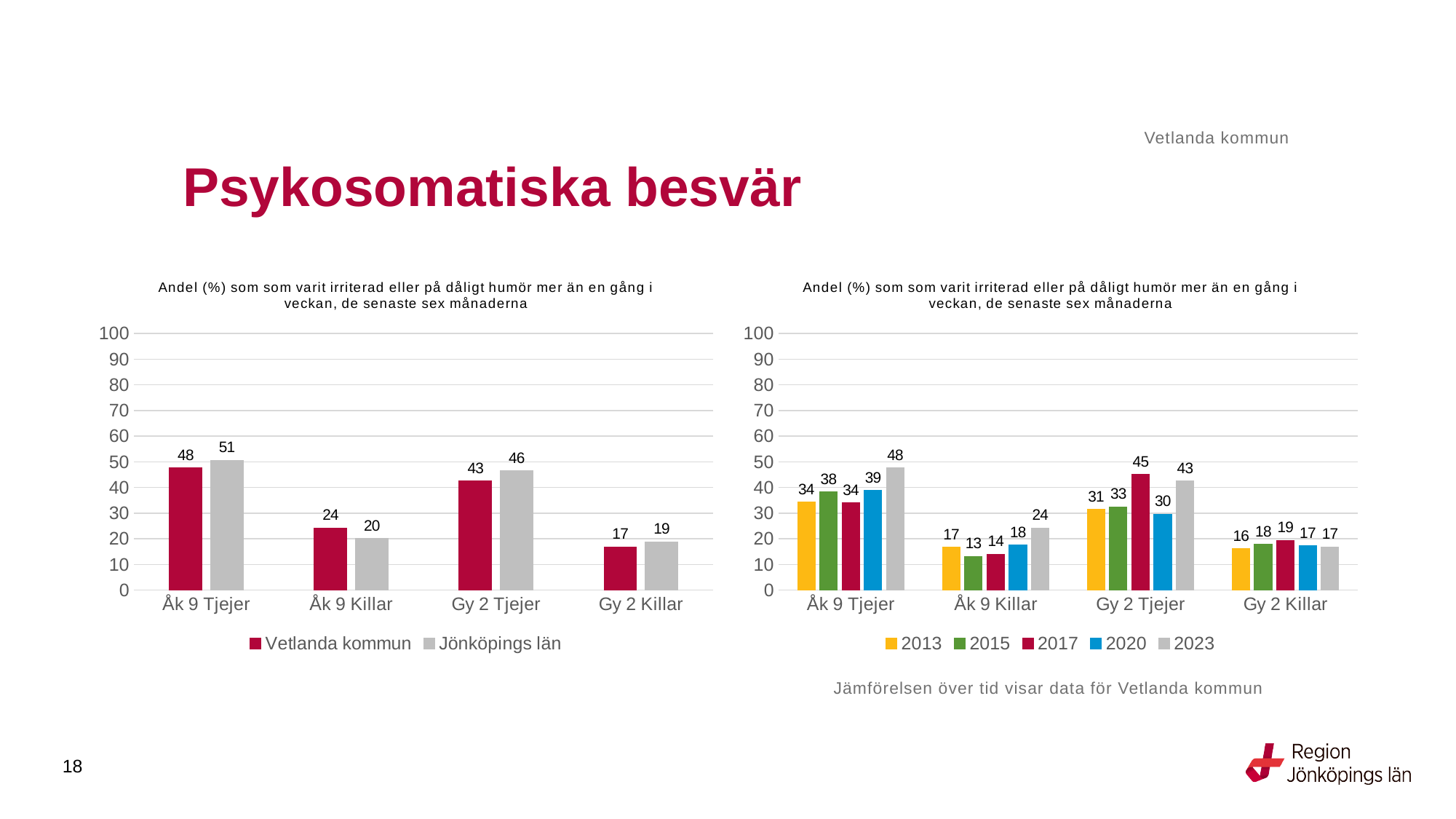
In the right chart, what is the value for 2023 for Åk 9 Tjejer? 48 In the right chart, what is the value for 2017 for Gy 2 Tjejer? 45 What kind of chart is the right chart? Bar chart In the left chart, which category has the lowest value for Vetlanda kommun? Gy 2 Killar In the left chart, which is larger for Gy 2 Tjejer: Vetlanda kommun or Jönköpings län? Jönköpings län In the left chart, what is the value for Jönköpings län for Gy 2 Killar? 19 In the right chart, what is the difference between 2023 and 2020 for Gy 2 Tjejer? 13 In the left chart, what is the value for Vetlanda kommun for Åk 9 Tjejer? 48 How many series does the legend of the right chart list? 5 In the right chart, which year has the lowest value for Åk 9 Killar? 2015 In the left chart, what is the difference between Jönköpings län and Vetlanda kommun for Åk 9 Killar? 4 How many series does the legend of the left chart list? 2